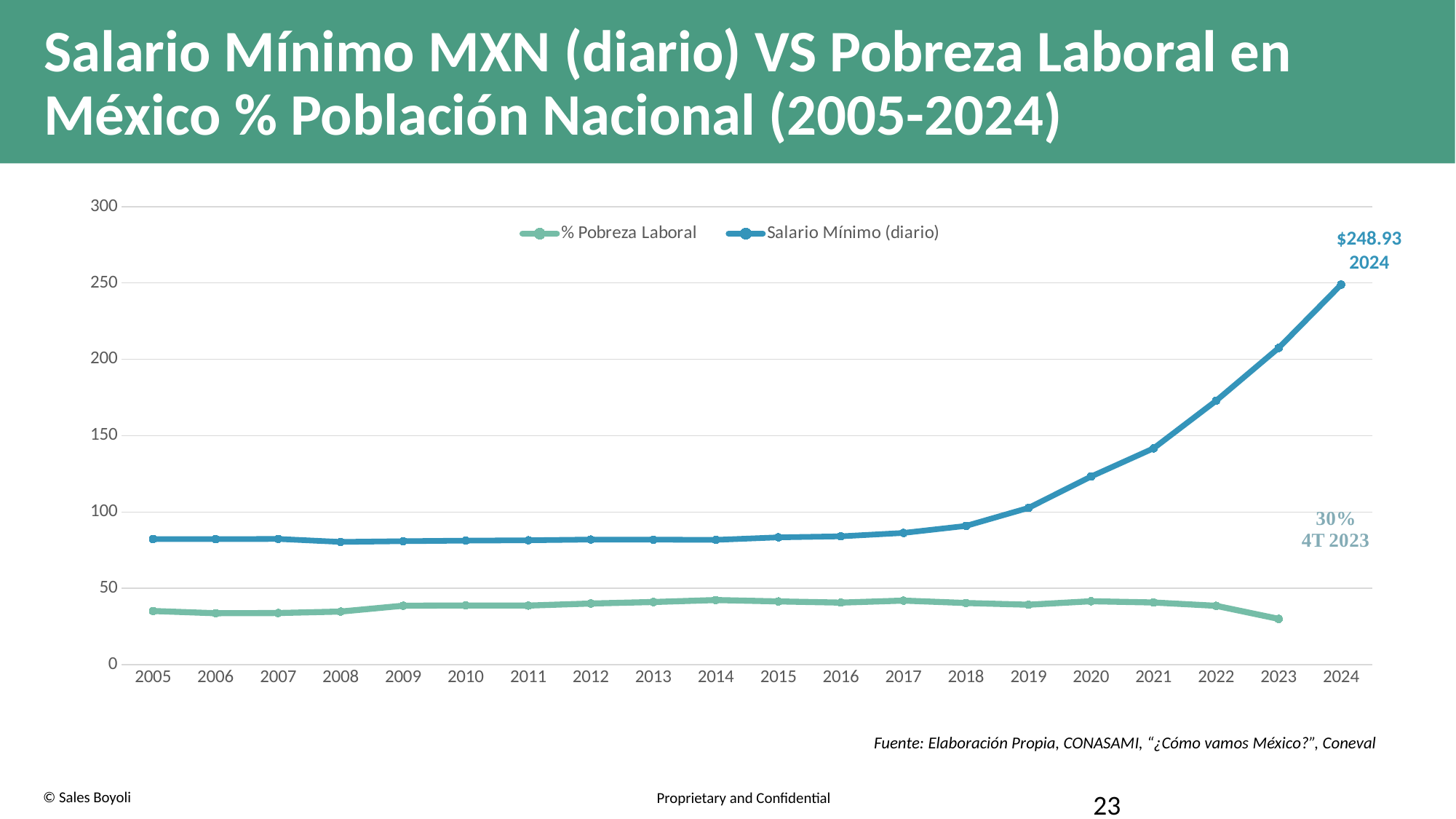
In 2010, which series has the higher value, % Pobreza Laboral or Salario Mínimo (diario)? Salario Mínimo (diario) Is the value for Salario Mínimo (diario) in 2022 greater or less than 150? greater How many years are shown along the x axis? 20 In which year is Salario Mínimo (diario) highest? 2024 In which year is % Pobreza Laboral lowest? 2023 What kind of chart is shown on the slide? line chart Does Salario Mínimo (diario) rise or fall from 2018 to 2024? rise What colour is the Salario Mínimo (diario) line? blue What is the value of % Pobreza Laboral in 2023? 30% How many series does the legend list? 2 What is the value of Salario Mínimo (diario) in 2024? $248.93 Is the value for % Pobreza Laboral in 2014 greater or less than 50? less